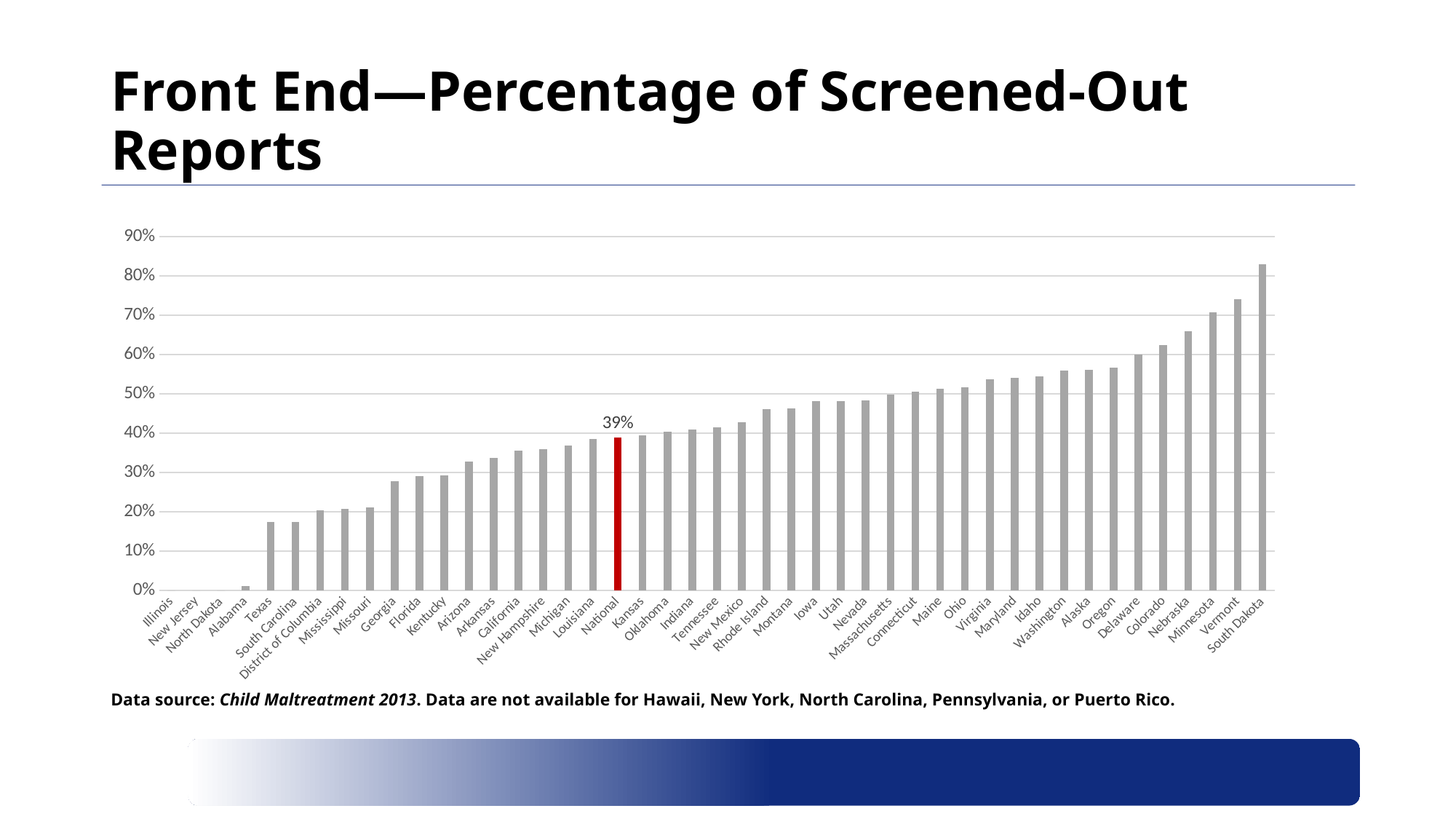
Is the value for Colorado greater or less than 60%? greater How many categories are plotted on the chart? 45 Is the value for Texas greater or less than 20%? less Is the value for South Dakota greater or less than 80%? greater Which bar is coloured red instead of grey? National Which has a higher value, Minnesota or Nebraska? Minnesota Which category has the highest percentage of screened-out reports? South Dakota What is the value printed for National? 39% What kind of chart is shown on the slide? bar chart Do the values rise or fall moving from left to right along the x axis? rise